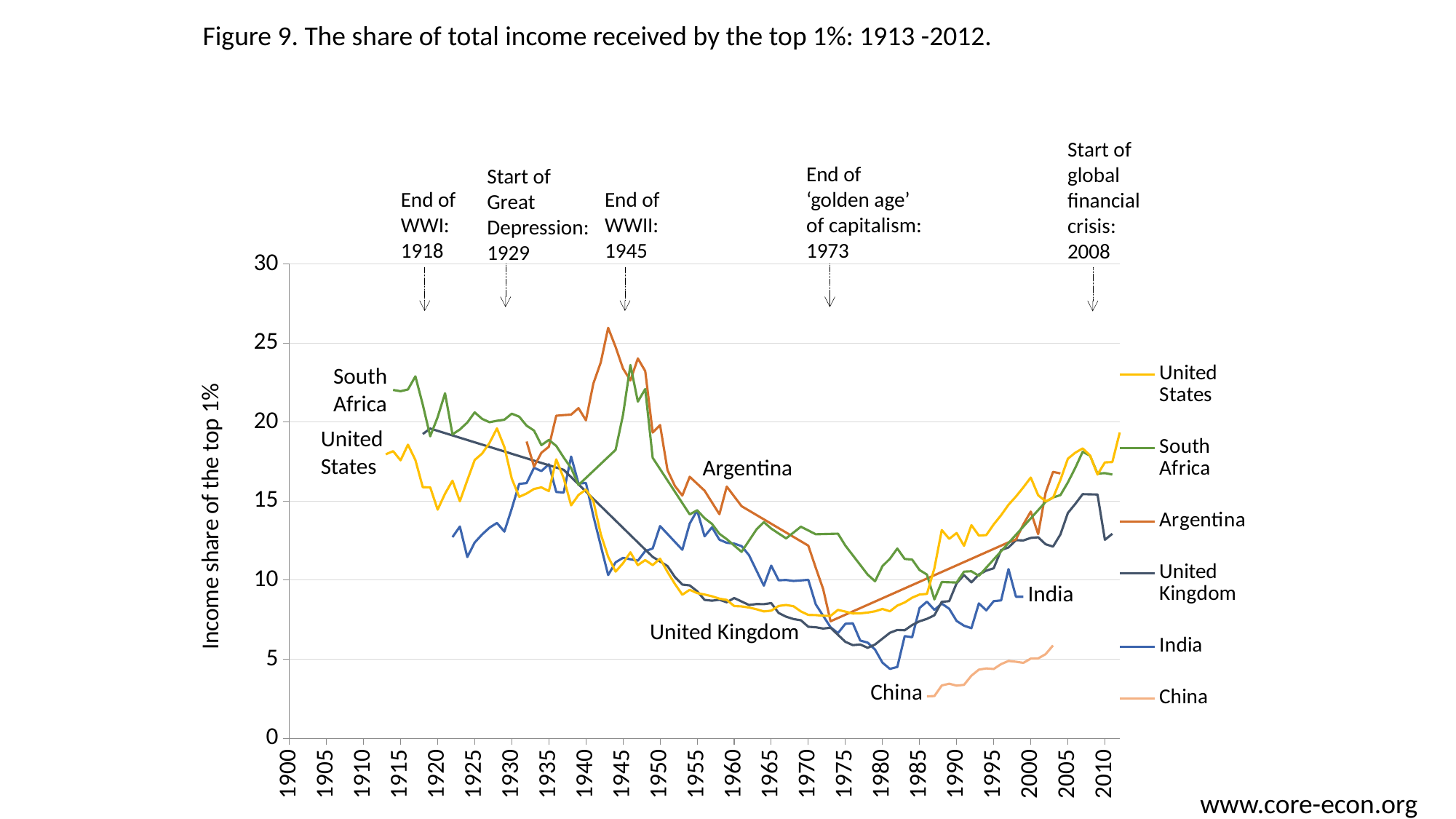
How many series does the legend list? 6 Which series reaches the highest value anywhere on the chart? Argentina What is the title of the chart? Figure 9. The share of total income received by the top 1%: 1913 -2012. What kind of chart is shown on the slide? line chart Is the value for South Africa in 1915 greater or less than 20? greater Is the peak value for Argentina in the early 1940s greater or less than 25? greater Is the value for China around 2003 greater or less than 10? less What is the label of the vertical axis? Income share of the top 1% Which series has the lowest values on the chart? China Does the United States series rise or fall between 1975 and 2012? rise